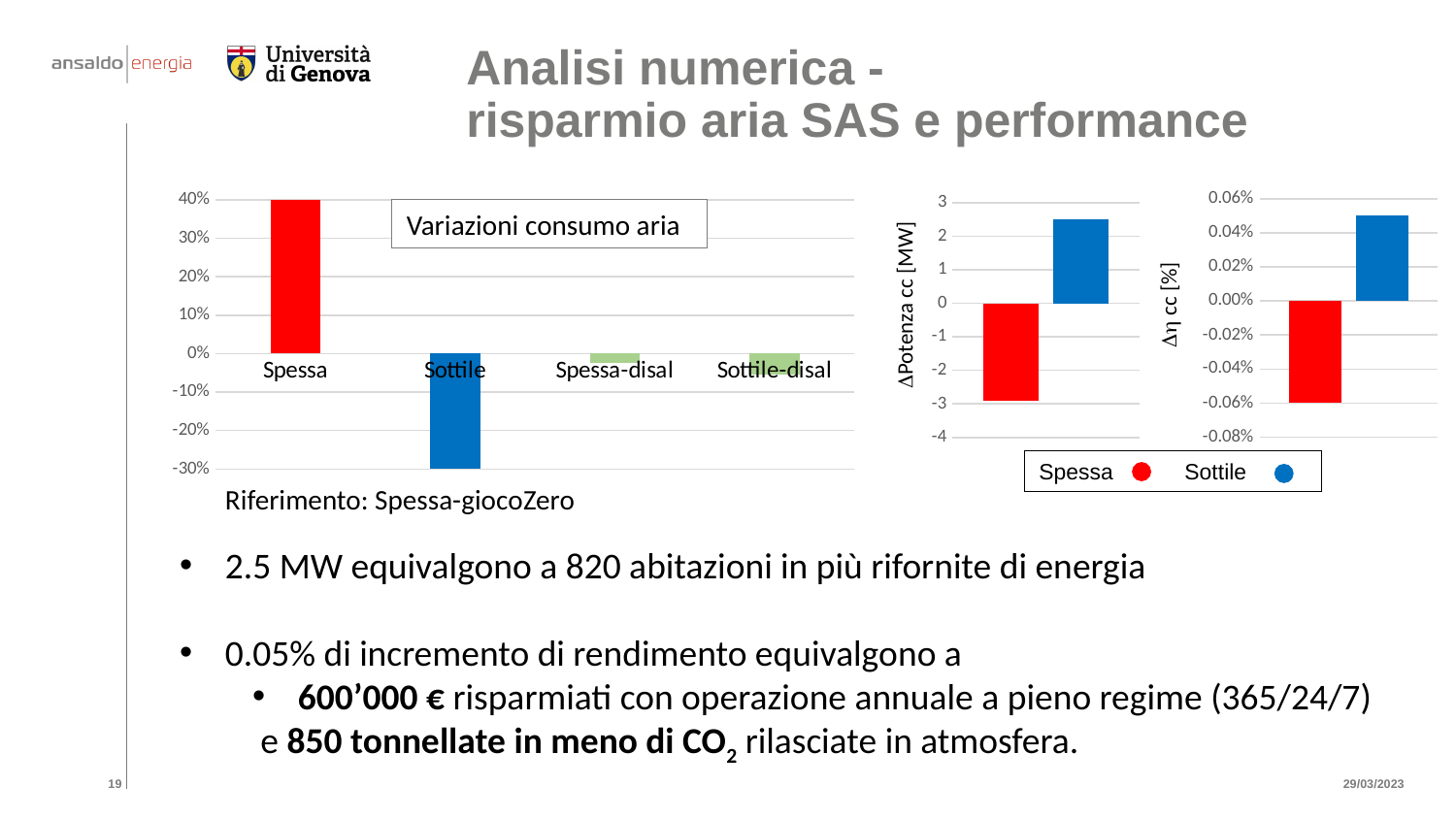
In the 'Variazioni consumo aria' chart, is the value for Spessa-disal greater or less than 0%? less In the ΔPotenza cc [MW] chart, what is the value for Spessa? -3 In the 'Variazioni consumo aria' chart, which category has the highest value? Spessa In the ΔPotenza cc [MW] chart, is the value for Sottile greater or less than 2? greater In the 'Variazioni consumo aria' chart, which category has the lowest value? Sottile In the Δη cc [%] chart, what is the value for Spessa? -0.06% What type of chart is the 'Variazioni consumo aria' chart? bar chart How many categories are shown in the 'Variazioni consumo aria' chart? 4 In the 'Variazioni consumo aria' chart, what is the value for Spessa? 40% How many series does the legend below the ΔPotenza cc and Δη cc charts list? 2 In the Δη cc [%] chart, is the value for Sottile greater or less than 0.04%? greater In the 'Variazioni consumo aria' chart, what is the value for Sottile? -30%